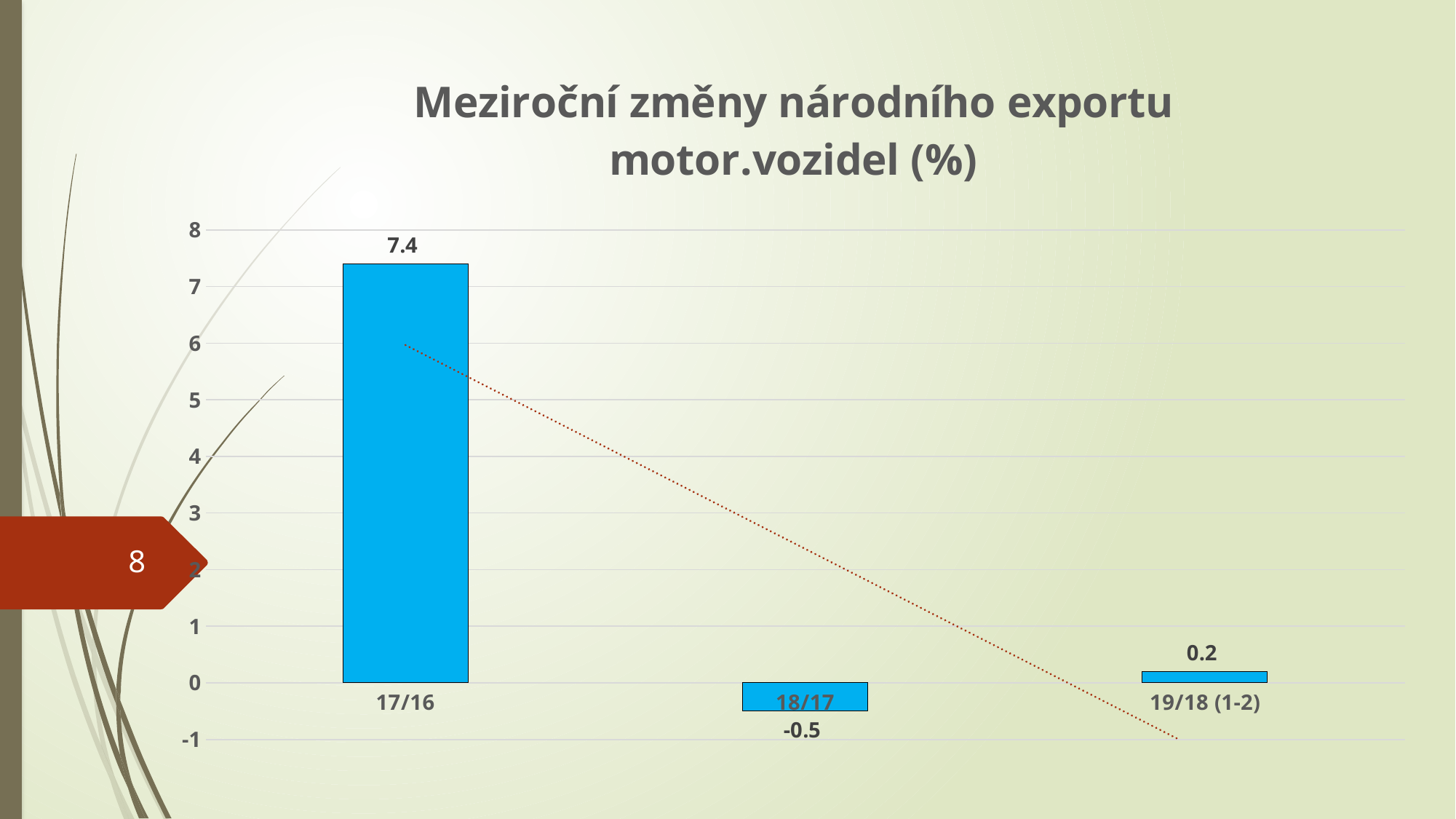
What is the difference between the values for 17/16 and 19/18 (1-2)? 7.2 What is the difference between the values for 19/18 (1-2) and 18/17? 0.7 What kind of chart is shown on the slide? bar chart How many categories are shown on the x axis? 3 What is the value for 18/17? -0.5 What is the value for 17/16? 7.4 Which category has the highest value? 17/16 Is the value for 17/16 greater or less than 7? greater Which is larger, the value for 18/17 or the value for 19/18 (1-2)? 19/18 (1-2) What is the value for 19/18 (1-2)? 0.2 Which category has the lowest value? 18/17 What is the title of the chart? Meziroční změny národního exportu motor.vozidel (%)